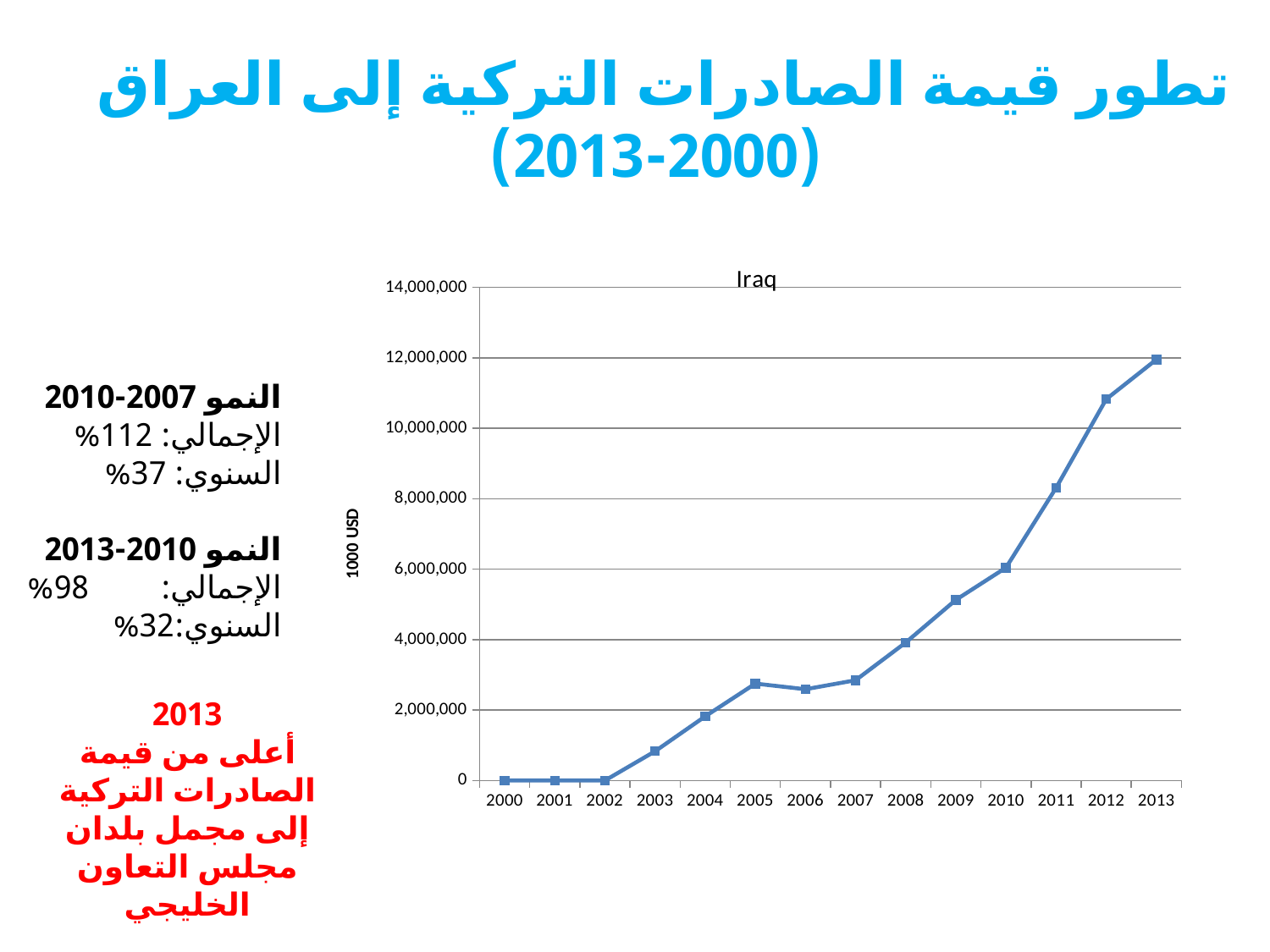
Which year has the larger value, 2004 or 2005? 2005 Which year has the highest value in the chart? 2013 Is the value for 2010 greater or less than 8,000,000? less How many years are plotted on the x axis of the chart? 14 What is the title of the chart? Iraq Is the value for 2013 greater or less than 10,000,000? greater Is the value for 2011 greater or less than 8,000,000? greater What kind of chart is shown on the slide? line chart Which year has the larger value, 2009 or 2012? 2012 What is the label on the vertical axis of the chart? 1000 USD Do the values generally rise or fall from 2002 to 2013? rise